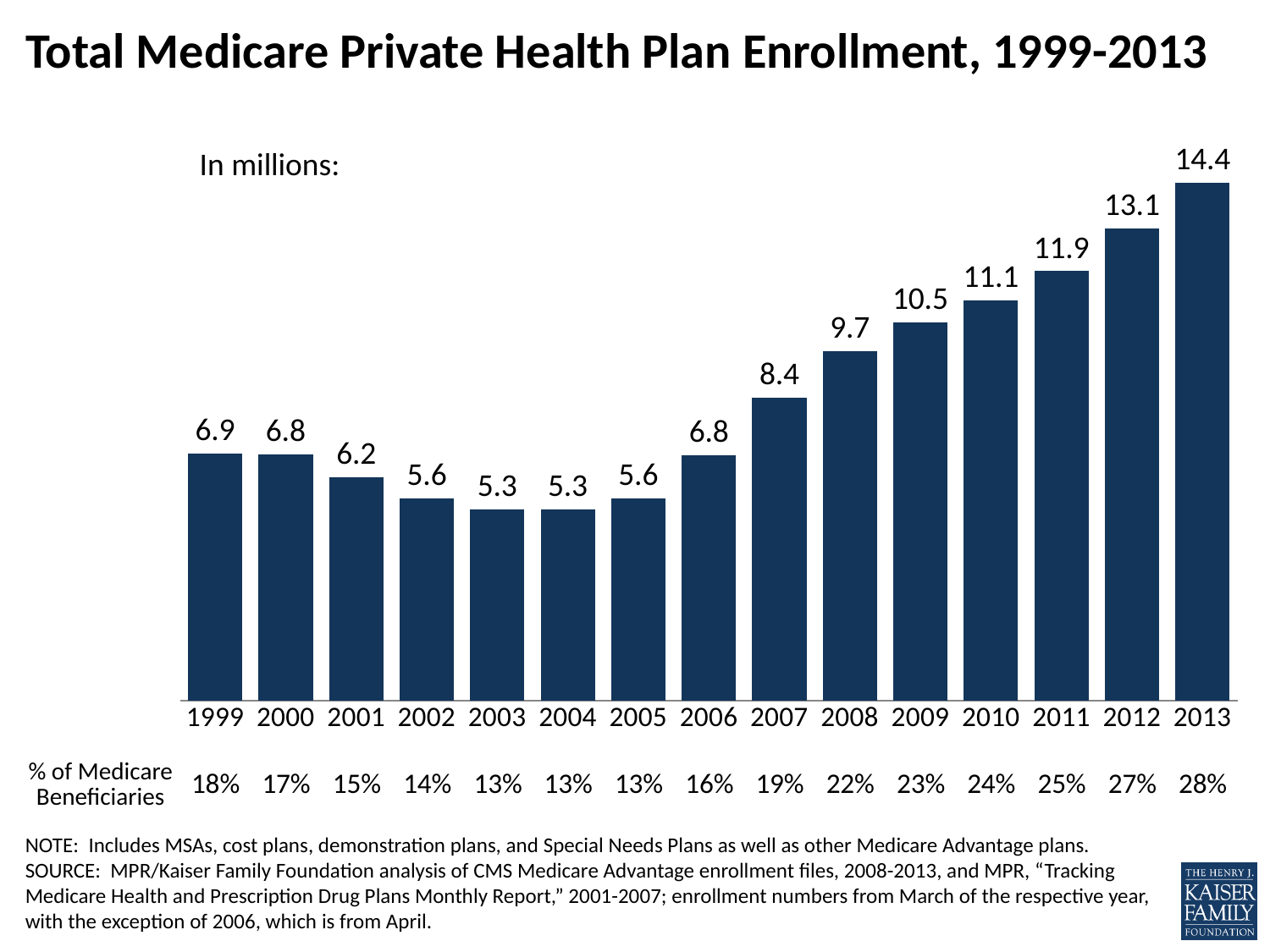
How many years are shown on the chart? 15 How much higher was enrollment in 2013 than in 1999, in millions? 7.5 What was total Medicare private health plan enrollment in 2008, in millions? 9.7 What is the difference in enrollment between 2012 and 2011, in millions? 1.2 What is the lowest enrollment value shown on the chart, in millions? 5.3 What unit are the enrollment values shown in? Millions Which year had higher enrollment, 2007 or 2006? 2007 What kind of chart is shown on the slide? Bar chart Which year had the highest enrollment? 2013 What was total Medicare private health plan enrollment in 2001, in millions? 6.2 What percent of Medicare beneficiaries were enrolled in private health plans in 2013? 28% Did enrollment rise or fall from 2005 to 2013? Rise